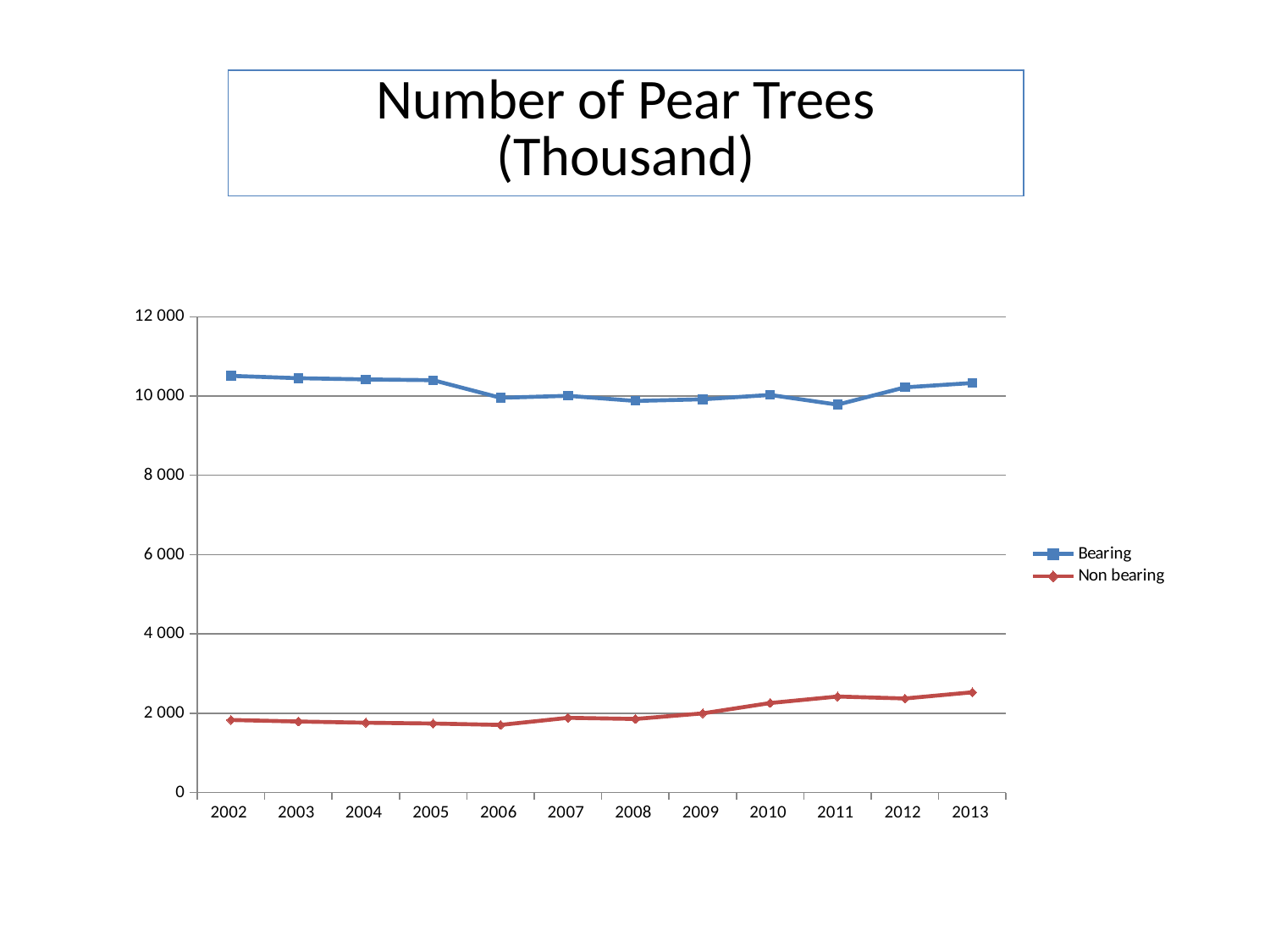
Is the value for Non bearing in 2013 greater or less than 2 000? greater Is the value for Bearing in 2011 greater or less than 10 000? less Does the Non bearing series rise or fall overall from 2002 to 2013? rise Is the value for Bearing in 2002 greater or less than 10 000? greater What is the title of the chart? Number of Pear Trees (Thousand) How many series does the legend list? 2 How many years are plotted along the x axis? 12 What kind of chart is shown on the slide? line chart Which series has the larger value in 2013, Bearing or Non bearing? Bearing Which series is drawn in red? Non bearing In which year is the Non bearing series at its highest? 2013